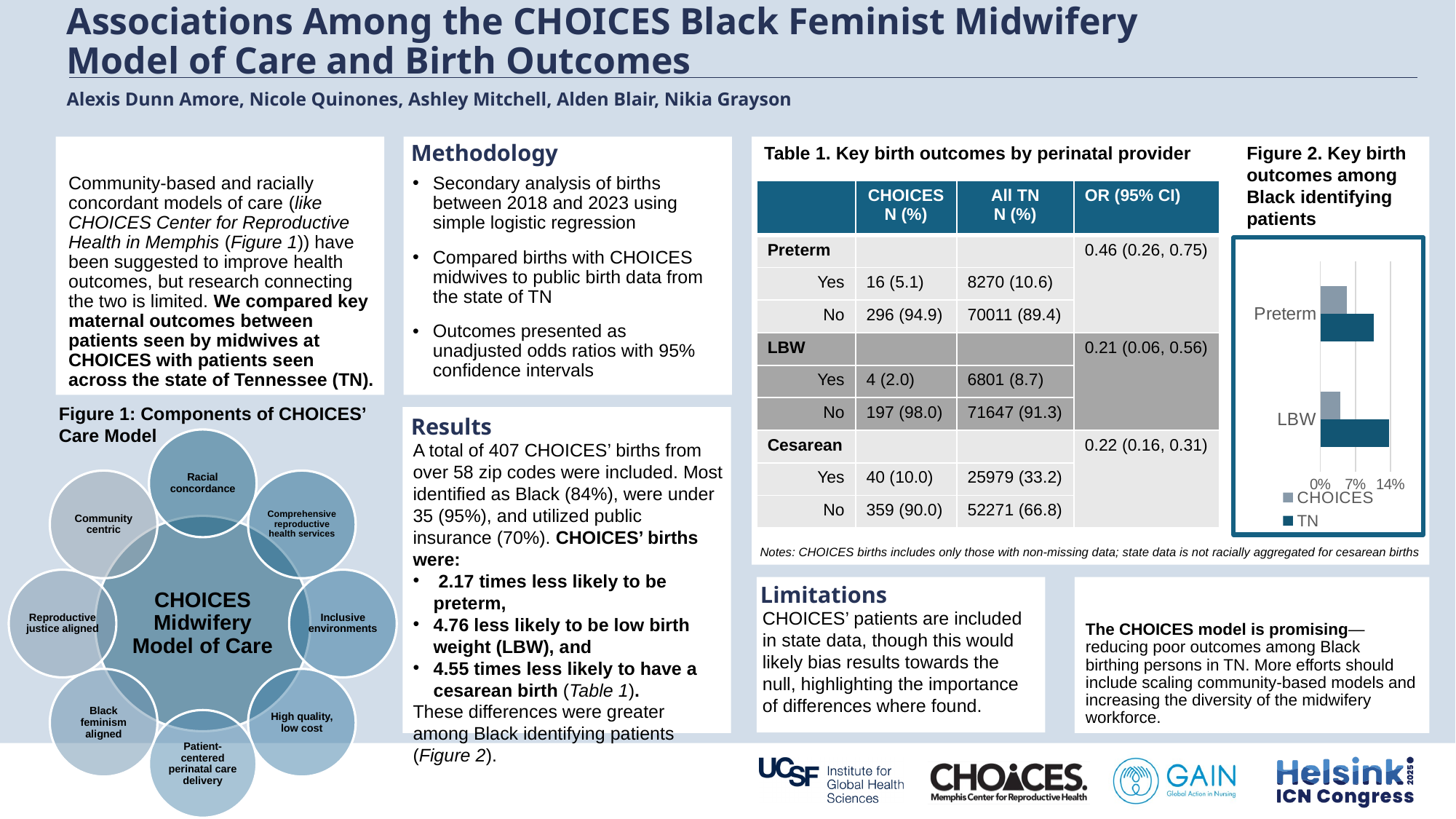
In Figure 2, how many outcome categories are plotted on the chart? 2 In Figure 2, for Preterm, which series has the larger value, CHOICES or TN? TN In Figure 2, which two series are shown in the legend? CHOICES and TN In Figure 2, is the TN value for Preterm greater or less than 7%? greater In Figure 2, how many series does the legend list? 2 In Figure 2, which bar is the tallest (largest value) on the chart? TN for LBW In Figure 2, for LBW, which series has the larger value, CHOICES or TN? TN In Figure 2, what is the title of the chart? Figure 2. Key birth outcomes among Black identifying patients In Figure 2, is the CHOICES value for Preterm greater or less than 7%? less In Figure 2, is the TN value for LBW greater or less than 7%? greater In Figure 2, what kind of chart is used to show key birth outcomes among Black identifying patients? bar chart